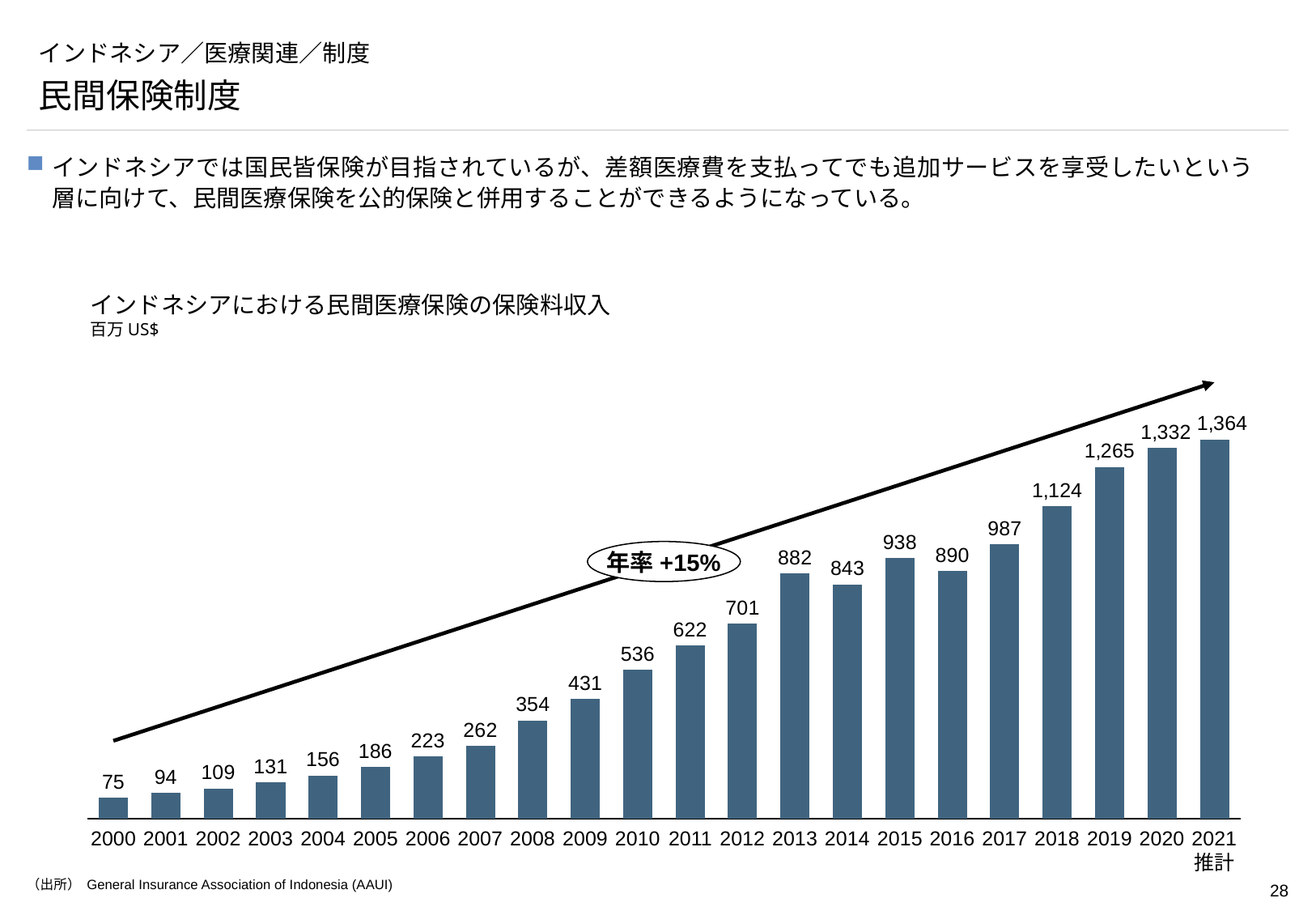
What is the value for 2000? 75 Which year has the lowest value? 2000 Do the values generally rise or fall from 2000 to 2021? rise What is the value for 2010? 536 Which is larger, the value for 2013 or the value for 2014? 2013 What annual growth rate is shown in the label on the arrow? 年率 +15% What is the value for 2021 (推計)? 1,364 Which year has the highest value? 2021 What unit is stated under the chart title? 百万 US$ What kind of chart is this? bar chart What is the difference between the values for 2020 and 2019? 67 How many years are shown on the x axis? 22